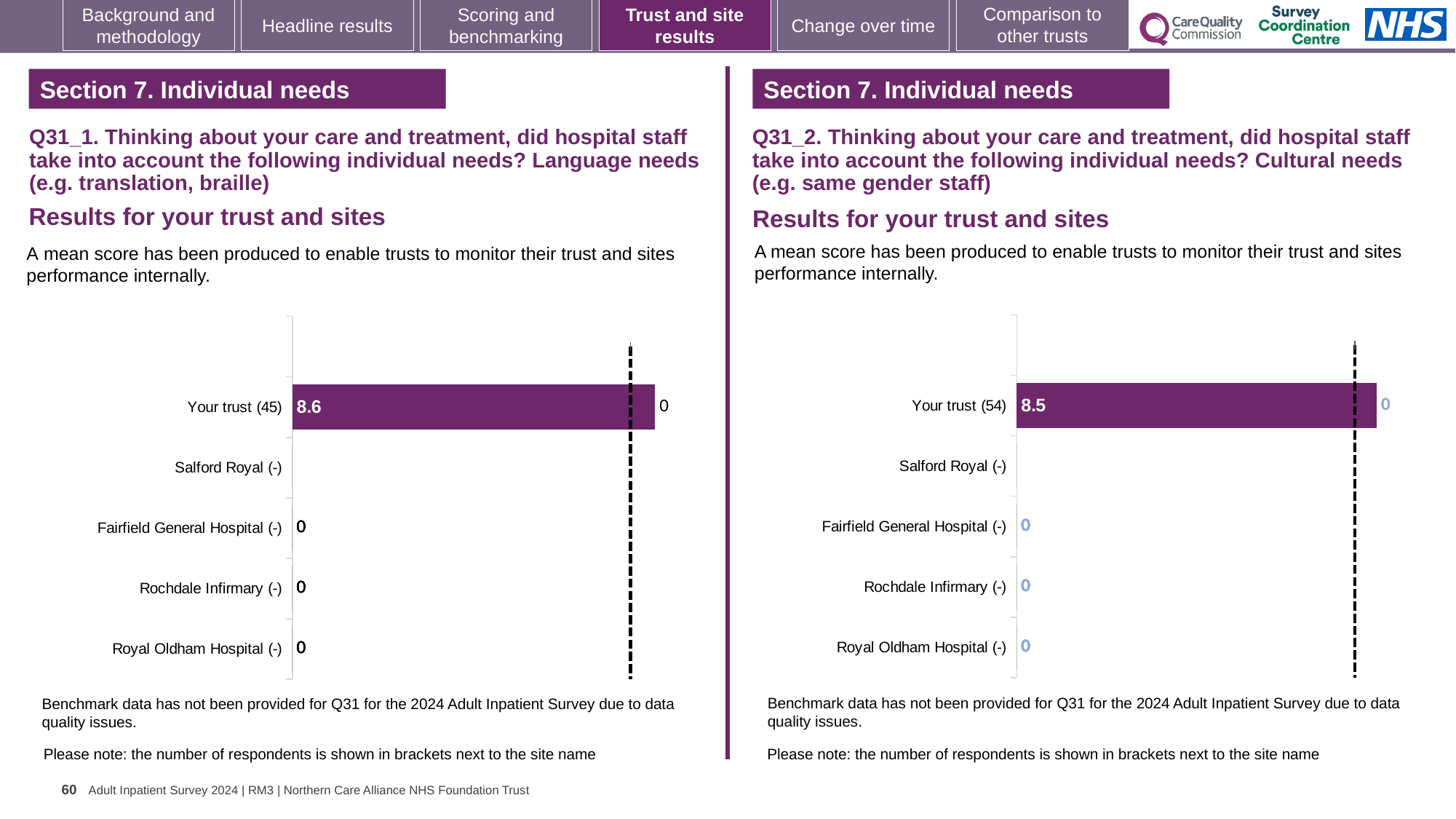
On the right chart (Q31_2, Cultural needs), which category has the highest score? Your trust (54) On the right chart (Q31_2, Cultural needs), how many categories are listed on the vertical axis? 5 What kind of chart is used on the left side of the slide (Q31_1)? Bar chart On the right chart (Q31_2, Cultural needs), what value is printed for Fairfield General Hospital? 0 On the left chart (Q31_1, Language needs), which category has the highest score? Your trust (45) On the left chart (Q31_1, Language needs), what is the mean score for Your trust? 8.6 On the left chart (Q31_1, Language needs), how many categories are listed on the vertical axis? 5 What is the difference between the Your trust score on the left chart (Q31_1) and the Your trust score on the right chart (Q31_2)? 0.1 Is the Your trust score on the left chart (Q31_1) larger or smaller than the Your trust score on the right chart (Q31_2)? Larger On the right chart (Q31_2), how many respondents are shown in brackets next to Your trust? 54 On the left chart (Q31_1), how many respondents are shown in brackets next to Your trust? 45 On the right chart (Q31_2, Cultural needs), what is the mean score for Your trust? 8.5